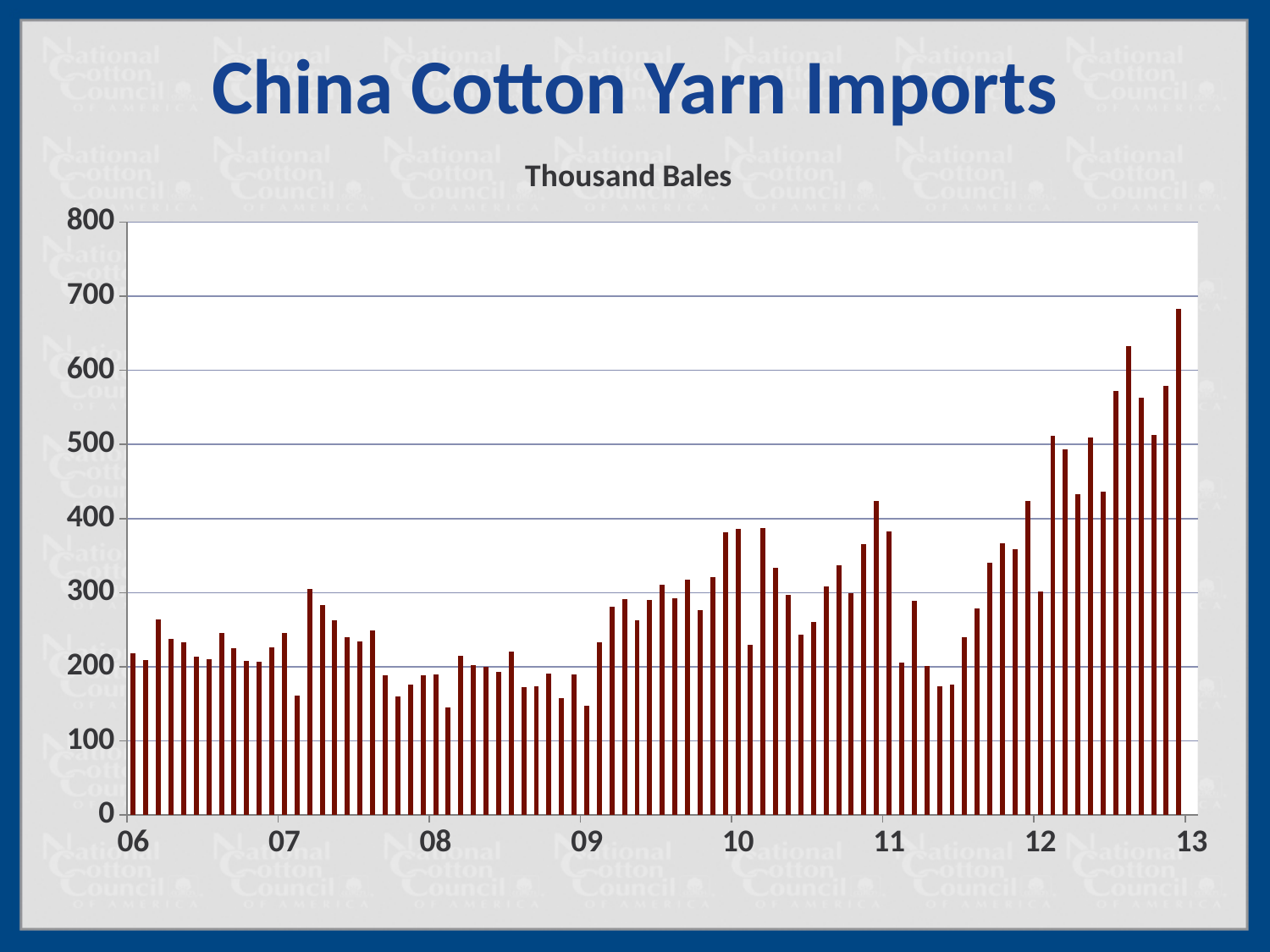
How many year labels are shown along the horizontal axis? 8 Is the value of the first bar (at 06) greater or less than 200? greater Is the value of the bar at the 11 tick greater or less than 300? greater What kind of chart is shown on the slide? Bar chart What is the title of the chart? China Cotton Yarn Imports In what unit are the values on the chart expressed? Thousand Bales What is the highest value shown on the vertical axis? 800 Which is larger, the first bar (at 06) or the last bar (at 13)? The last bar (at 13) Is the value of the last bar (at 13) greater or less than 600? greater Overall, do China's cotton yarn imports rise or fall from 06 to 13? Rise In which year does the tallest bar on the chart appear? Just before 13 (end of 2012)